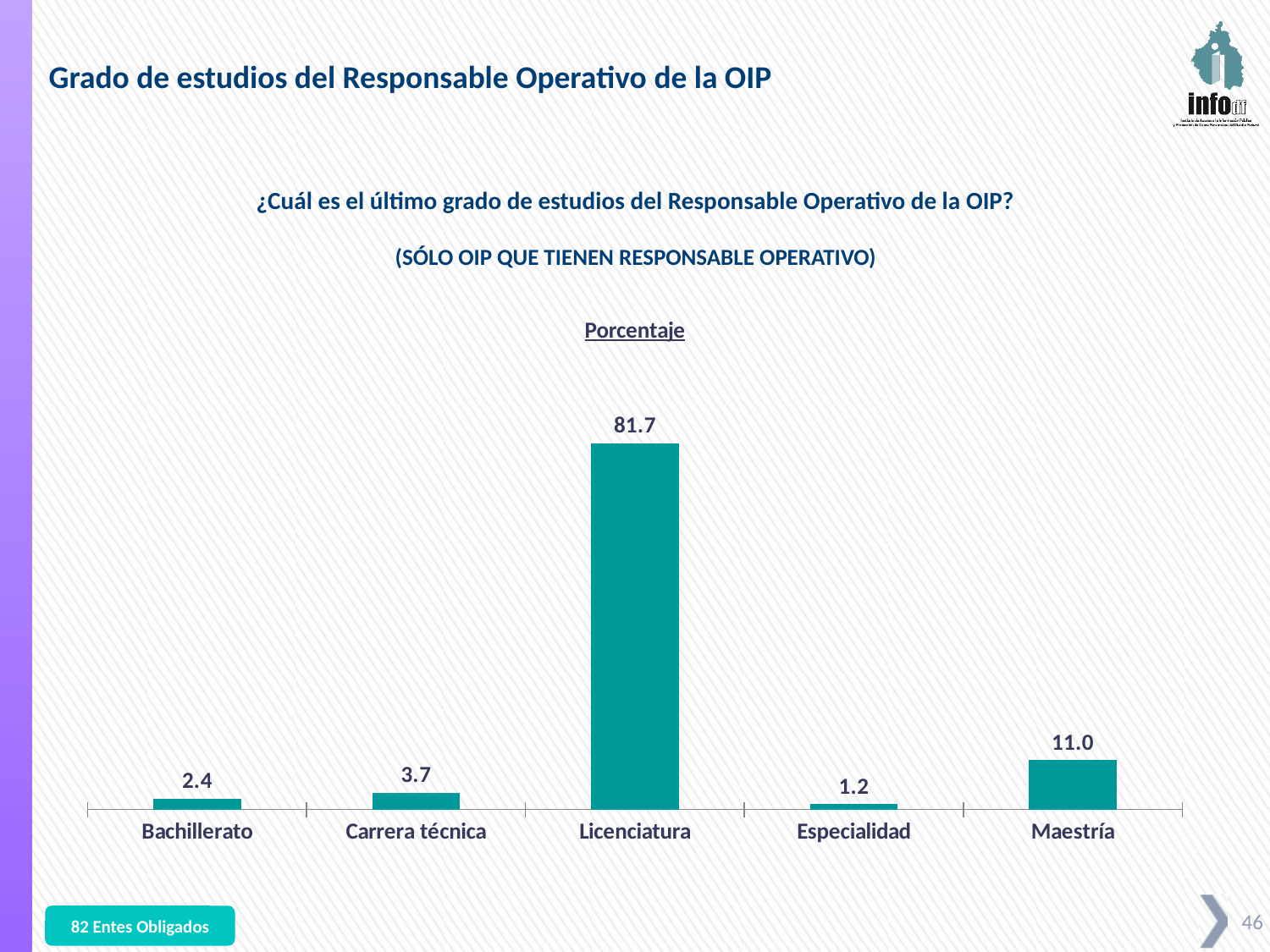
What is the value for Licenciatura? 81.7 Which is larger, the value for Carrera técnica or the value for Bachillerato? Carrera técnica What is the value for Maestría? 11.0 Which category has the lowest value? Especialidad What is the difference between the values for Licenciatura and Maestría? 70.7 What is the difference between the values for Carrera técnica and Bachillerato? 1.3 What is the value for Bachillerato? 2.4 What is the underlined label shown above the chart? Porcentaje What is the value for Especialidad? 1.2 What kind of chart is shown on the slide? Bar chart How many categories are shown on the x axis? 5 Which category has the highest value? Licenciatura